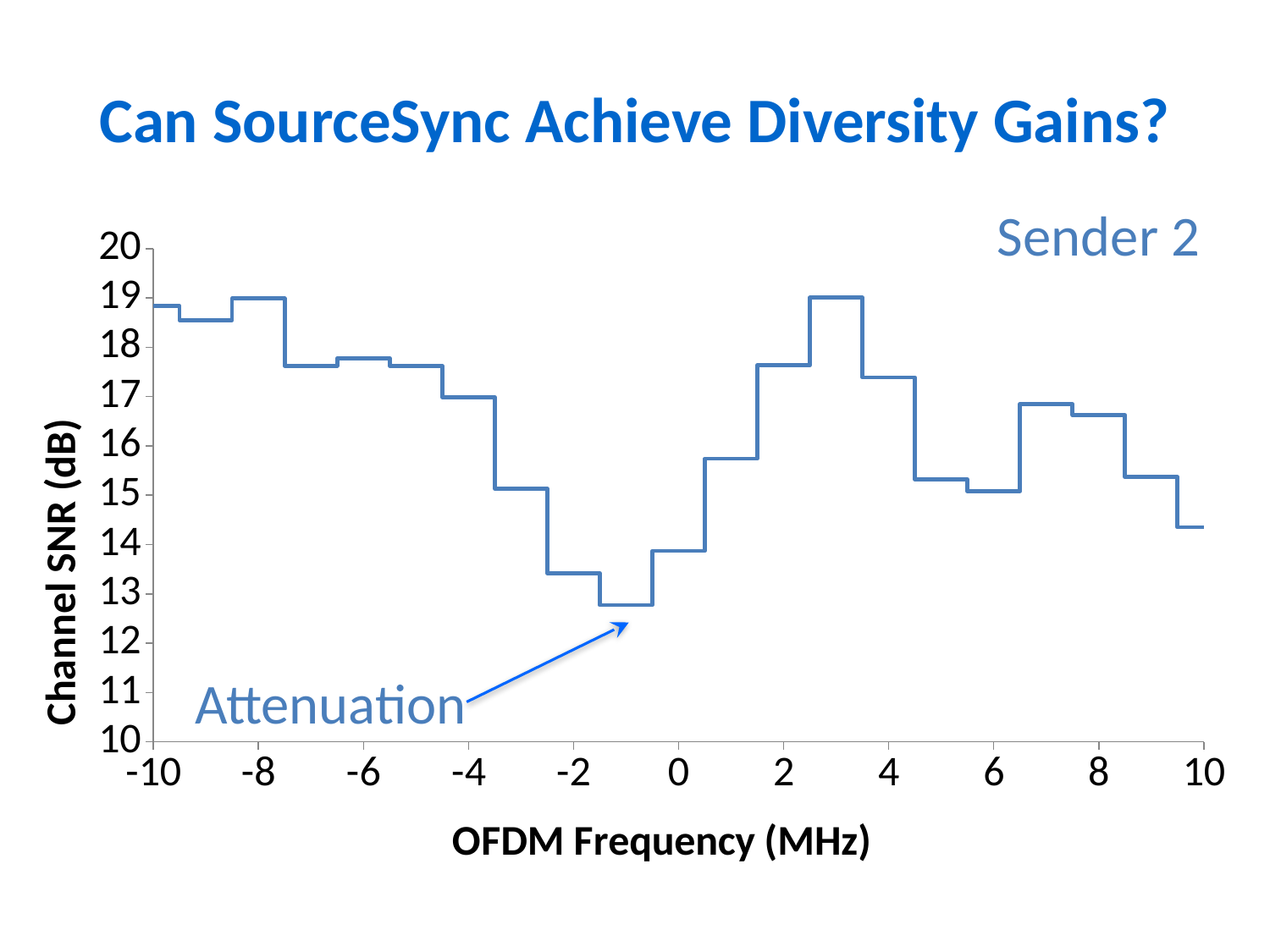
Is the channel SNR at 7 MHz greater or less than 16 dB? greater What kind of chart is shown on the slide? line chart Is the channel SNR at -9 MHz greater or less than 18 dB? greater In which frequency range does the channel SNR reach its lowest value? between -2 and 0 MHz What is the label of the y-axis? Channel SNR (dB) What is the label of the x-axis? OFDM Frequency (MHz) Which has the higher channel SNR: -9 MHz or 9 MHz? -9 MHz Is the channel SNR at 10 MHz greater or less than 15 dB? less Does the channel SNR rise or fall as frequency goes from -4 MHz to -1 MHz? fall Does the channel SNR rise or fall as frequency goes from -1 MHz to 3 MHz? rise